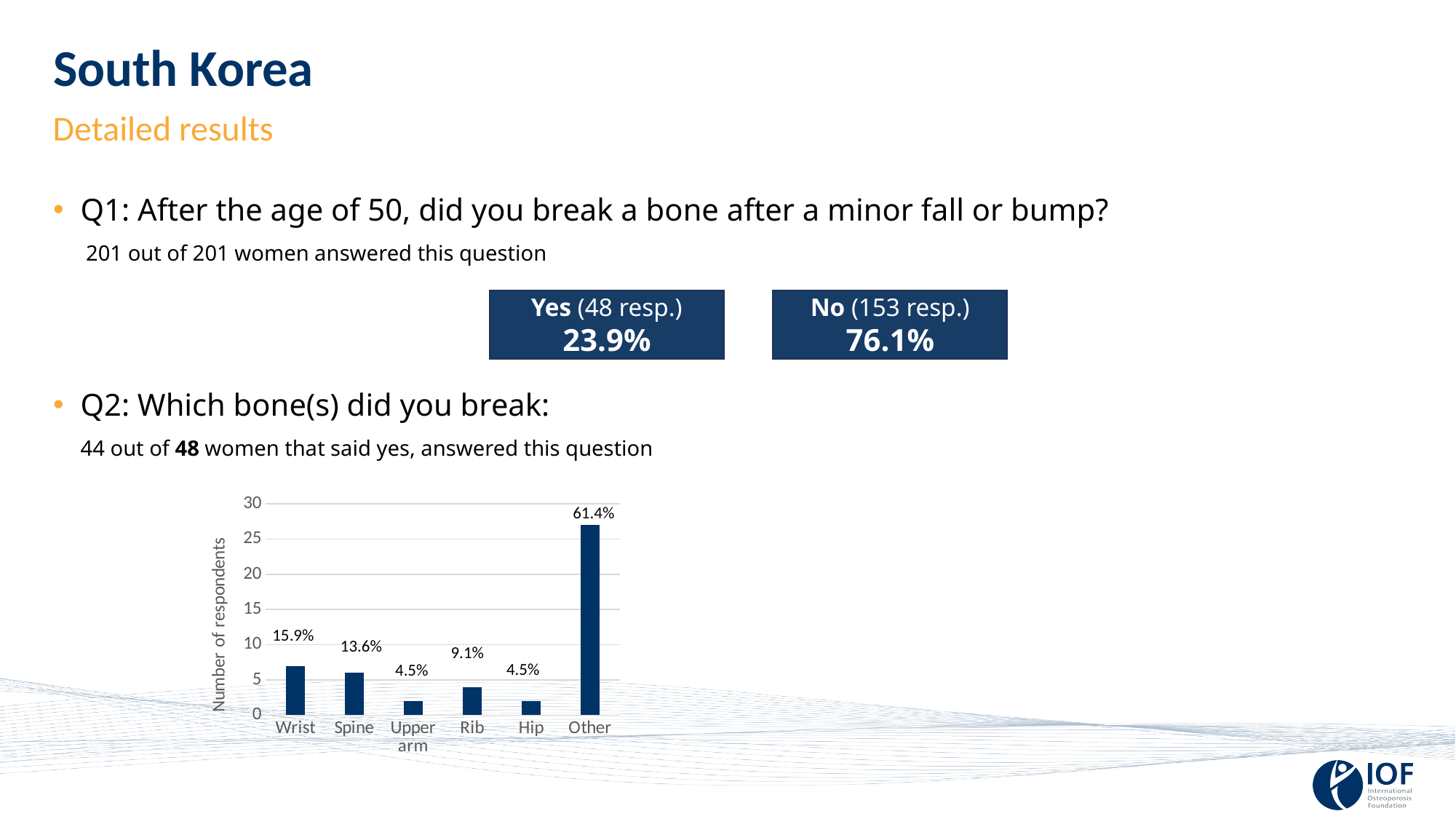
What percentage label is shown for Rib in the chart? 9.1% What percentage label is shown for Wrist in the chart? 15.9% What is the title of the vertical axis of the chart? Number of respondents What percentage label is shown above the Other bar in the chart? 61.4% Is the number of respondents for Wrist greater or less than 10? less Which category has the highest bar in the chart? Other What percentage label is shown for Hip in the chart? 4.5% Which has the larger percentage label, Wrist or Spine? Wrist How many bone categories are shown on the x axis of the chart? 6 What percentage label is shown for Spine in the chart? 13.6% Is the number of respondents for Other greater or less than 25? greater What is the difference between the percentage labels for Other and Wrist? 45.5%